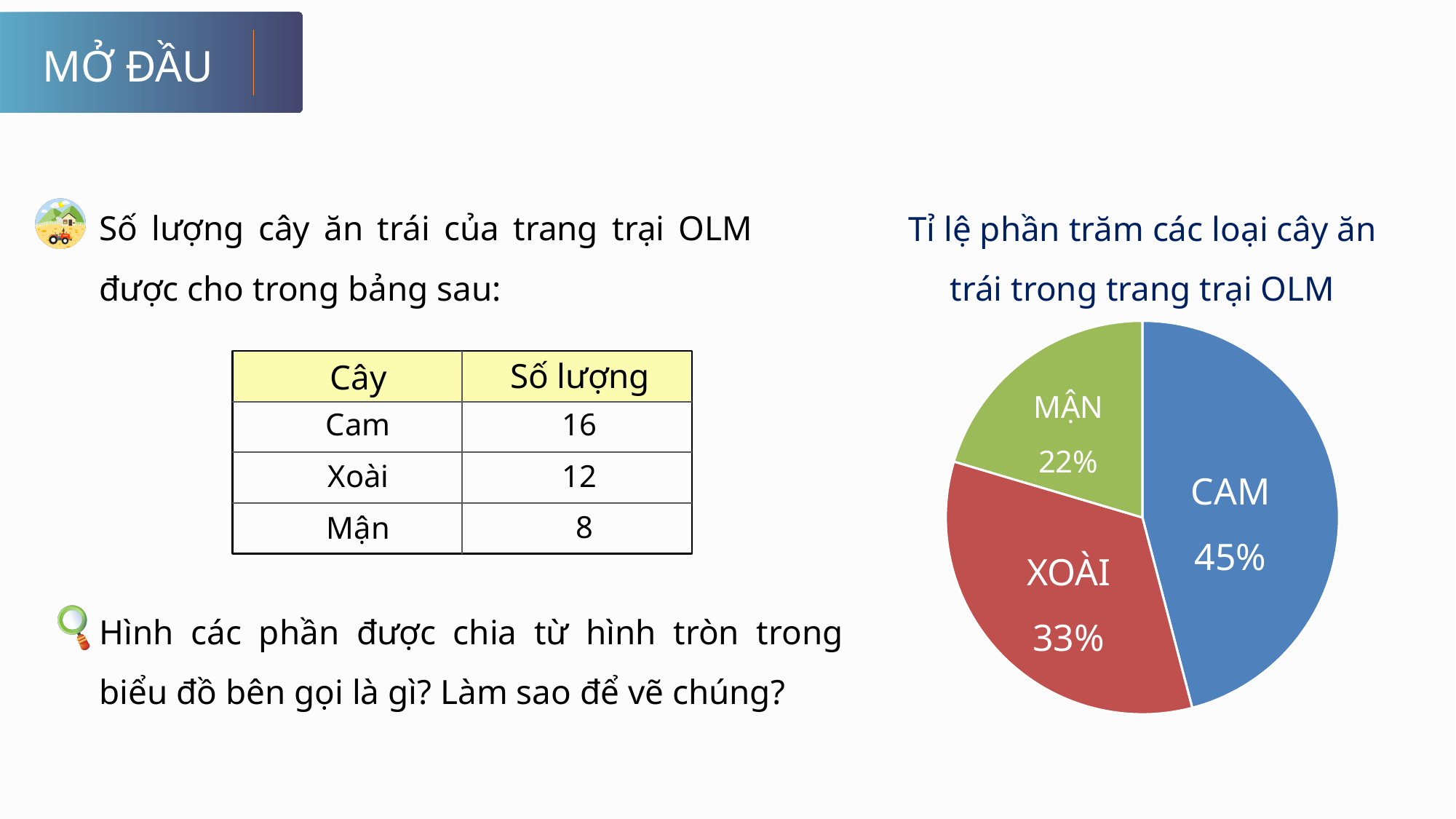
What is the difference in percentage points between the CAM slice and the XOÀI slice? 12 What percentage does the XOÀI slice show in the pie chart? 33% What is the title of the pie chart? Tỉ lệ phần trăm các loại cây ăn trái trong trang trại OLM What percentage does the CAM slice show in the pie chart? 45% Which slice of the pie chart is the smallest? MẬN Which slice of the pie chart is the largest? CAM How many slices does the pie chart have? 3 Which slice is larger in the pie chart, XOÀI or MẬN? XOÀI What is the difference in percentage points between the XOÀI slice and the MẬN slice? 11 What percentage does the MẬN slice show in the pie chart? 22% What type of chart is shown on the slide? pie chart What colour is the CAM slice in the pie chart? blue